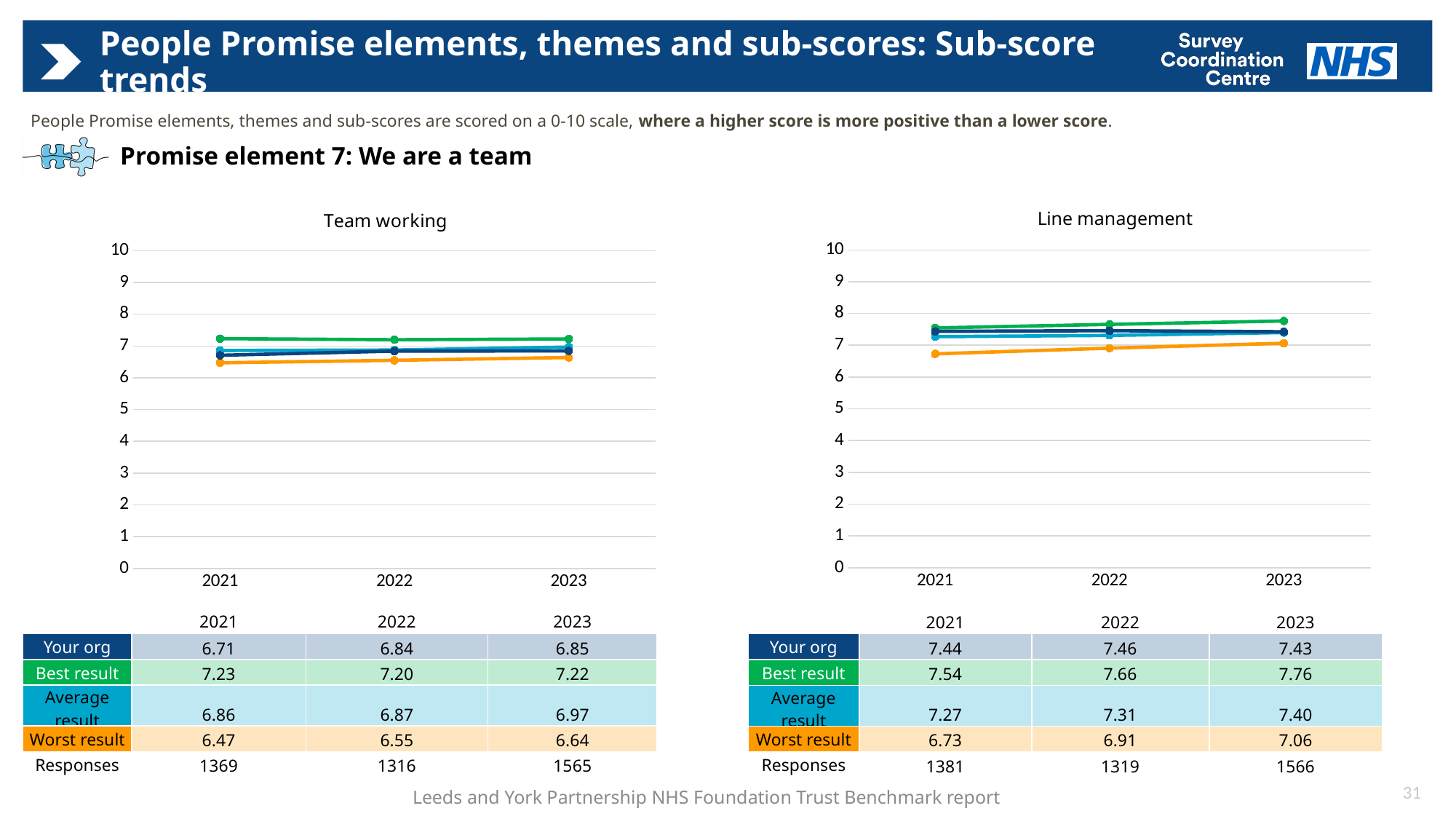
In the Line management chart, which series has the highest value in 2023? Best result In the Line management chart, what is the Best result value for 2022? 7.66 In the Line management chart, does the Worst result rise or fall from 2021 to 2023? rise What kind of chart is the Line management chart? line chart In the Team working chart, which is larger in 2022: the Your org value or the Average result? Average result In the Line management chart, what is the difference between the Best result and the Worst result in 2023? 0.70 In the Line management chart, what is the Average result value for 2023? 7.40 In the Team working chart, what is the Your org value for 2023? 6.85 In the Team working chart, what is the difference between the Your org value in 2023 and in 2021? 0.14 In the Team working chart, what is the Worst result value for 2021? 6.47 How many years are plotted on the x axis of the Team working chart? 3 In the Team working chart, which series has the lowest value in 2022? Worst result